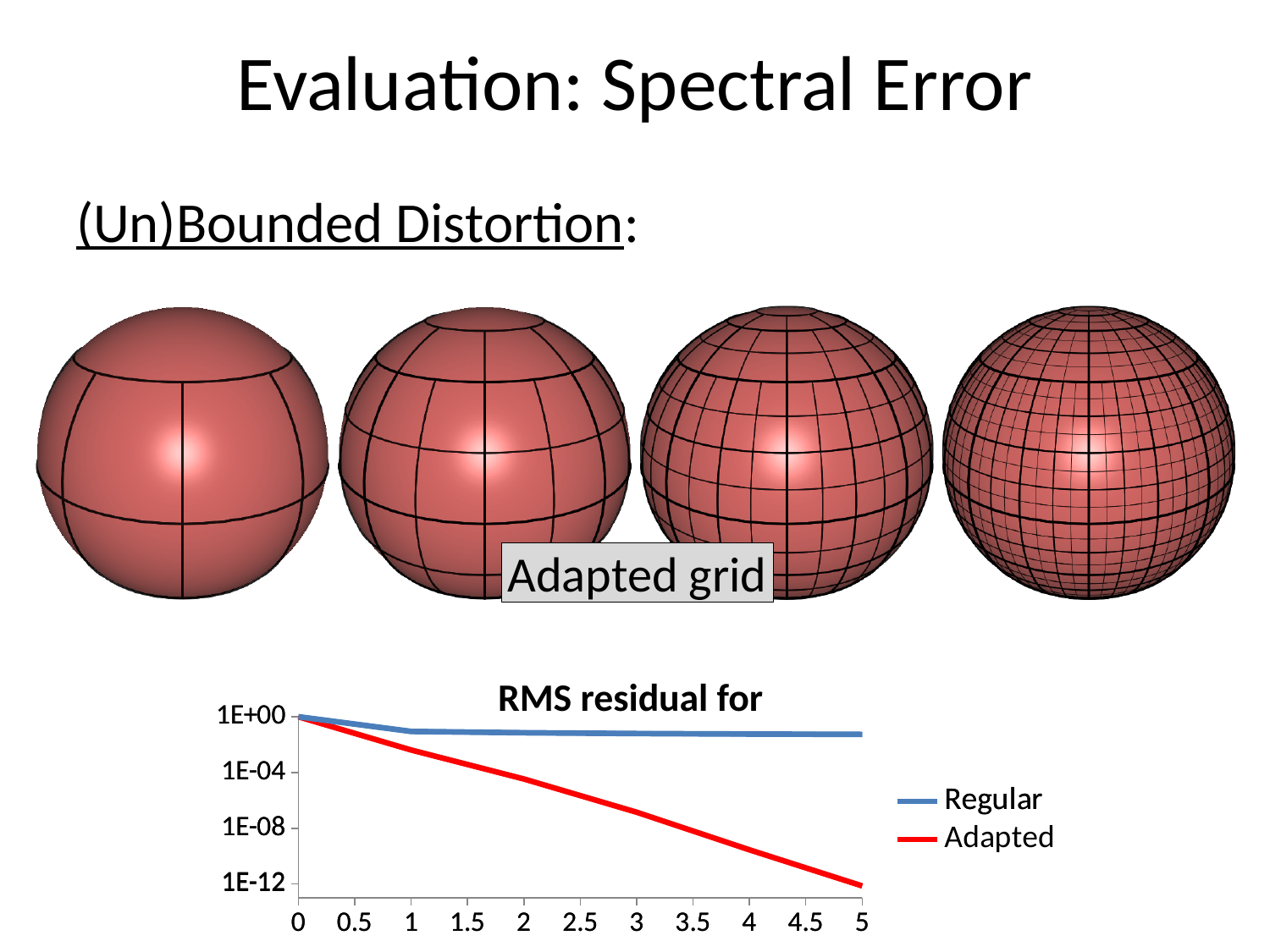
What kind of chart is shown on the slide? line chart What colour is the Adapted series line in the chart? red Which series has the lower value at x = 5, Regular or Adapted? Adapted Which series shows the steeper decrease across the x axis? Adapted How many series does the chart's legend list? 2 Is the value of the Adapted series at x = 5 greater or less than 1E-08? less Is the value of the Adapted series at x = 3 greater or less than 1E-04? less Is the value of the Regular series at x = 5 greater or less than 1E-04? greater How many tick labels are shown on the chart's x axis? 11 Which series has the higher value at x = 3, Regular or Adapted? Regular Does the Adapted series rise or fall as x increases from 0 to 5? fall What are the names of the two series in the chart's legend? Regular and Adapted